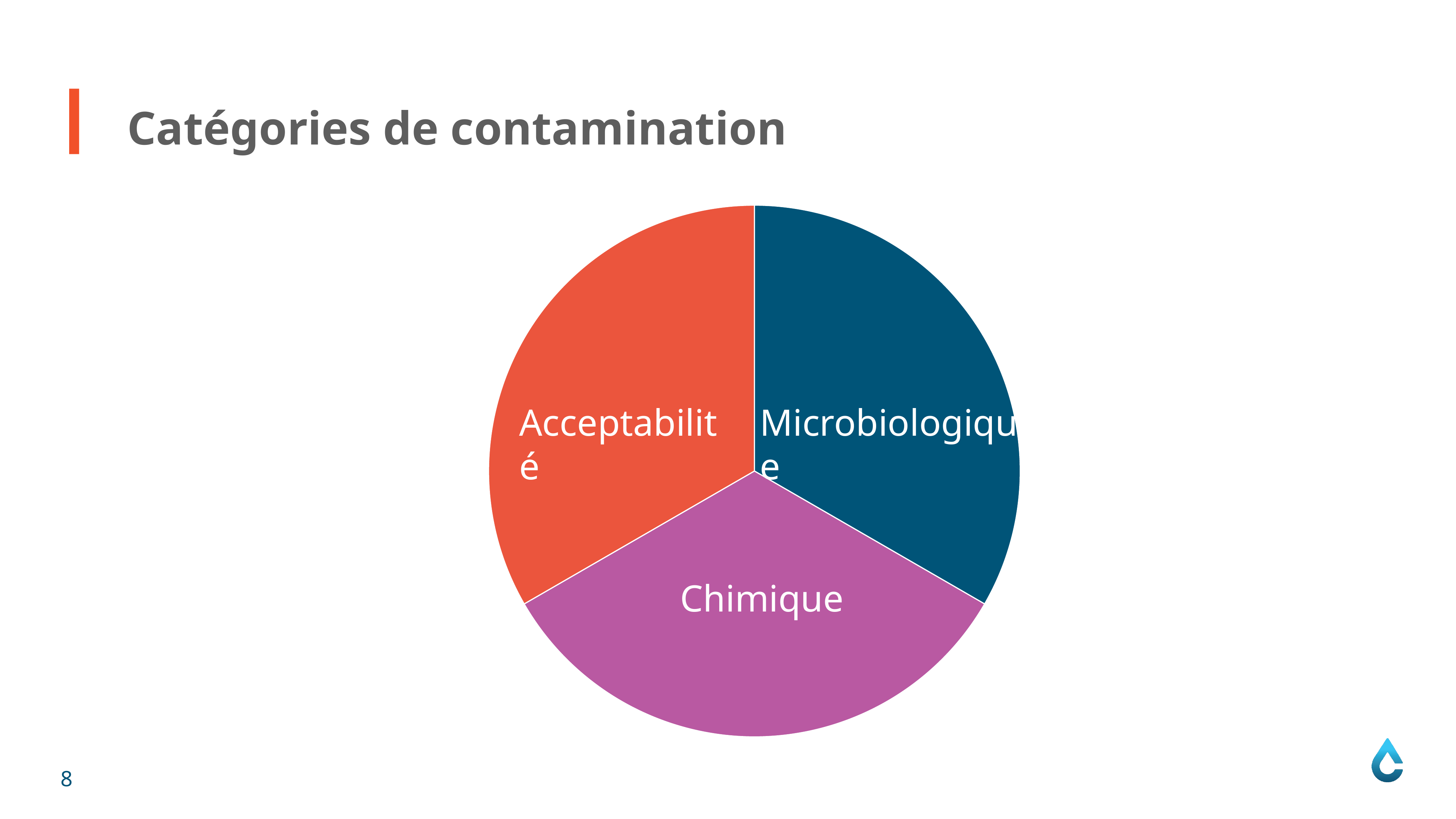
Which category is labelled on the purple slice of the pie chart? Chimique Which category is labelled on the orange-red slice of the pie chart? Acceptabilité Which slice of the pie chart is coloured dark blue? Microbiologique What is the title of the slide containing the pie chart? Catégories de contamination How many slices does the pie chart have? 3 Which three categories are shown in the pie chart? Acceptabilité, Microbiologique, Chimique What kind of chart is shown on the slide? Pie chart